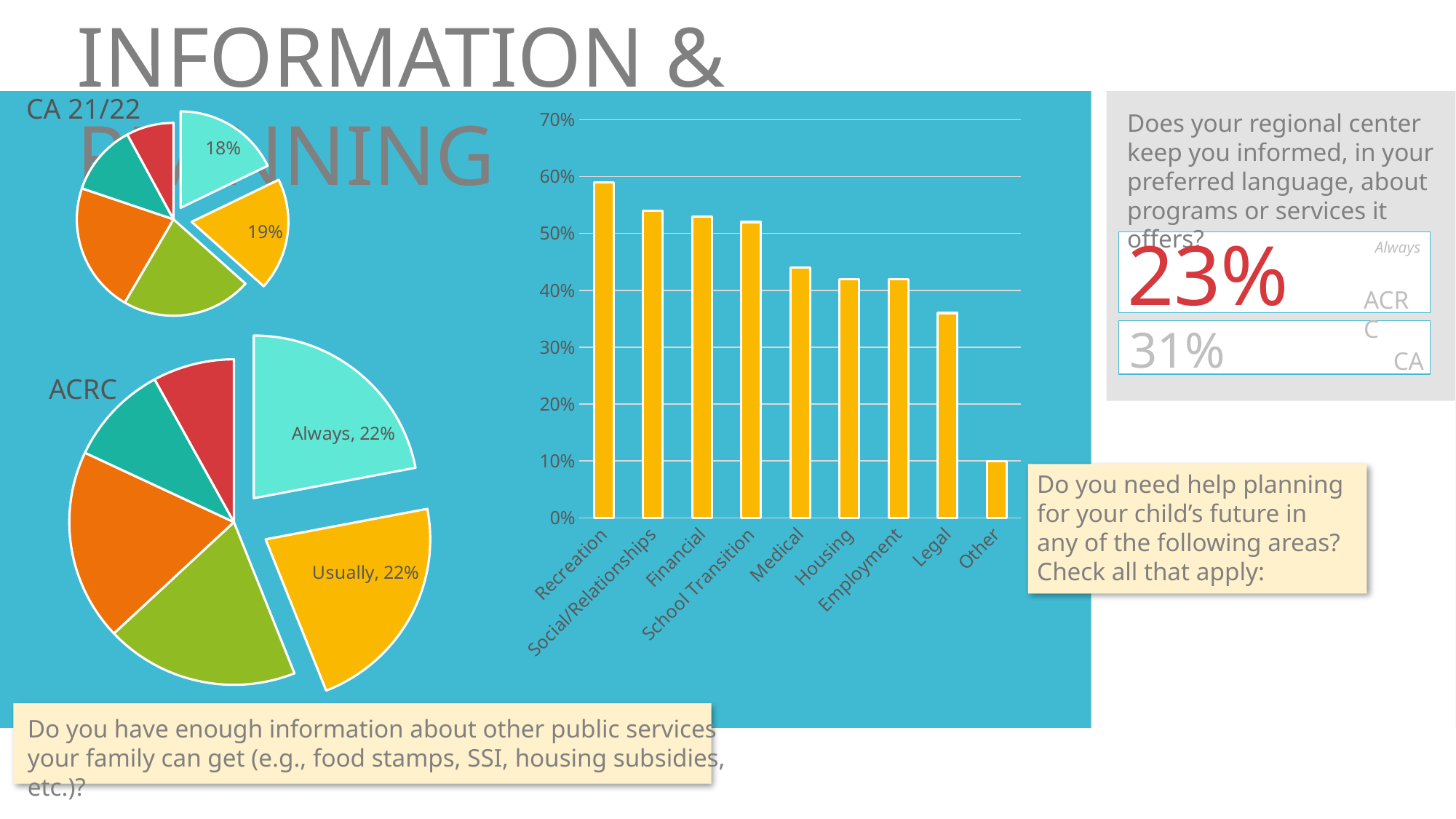
In the bar chart in the middle of the slide, is the value for Other greater or less than 20%? less In the CA 21/22 pie chart, what percentage is printed on the yellow slice? 19% In the bar chart in the middle of the slide, which category has the highest value? Recreation In the bar chart in the middle of the slide, do the values generally rise or fall from left to right along the x axis? fall In the CA 21/22 pie chart, what percentage is printed on the light teal exploded slice? 18% In the ACRC pie chart, what percentage is shown for the 'Always' slice? 22% What type of chart is the chart in the middle of the slide showing Recreation, Financial, Medical and other areas? bar chart In the bar chart in the middle of the slide, is the value for Recreation greater or less than 50%? greater In the bar chart in the middle of the slide, which is larger, the value for Recreation or the value for Legal? Recreation In the bar chart in the middle of the slide, which category has the lowest value? Other How many categories are shown on the x axis of the bar chart in the middle of the slide? 9 In the ACRC pie chart, what percentage is shown for the 'Usually' slice? 22%